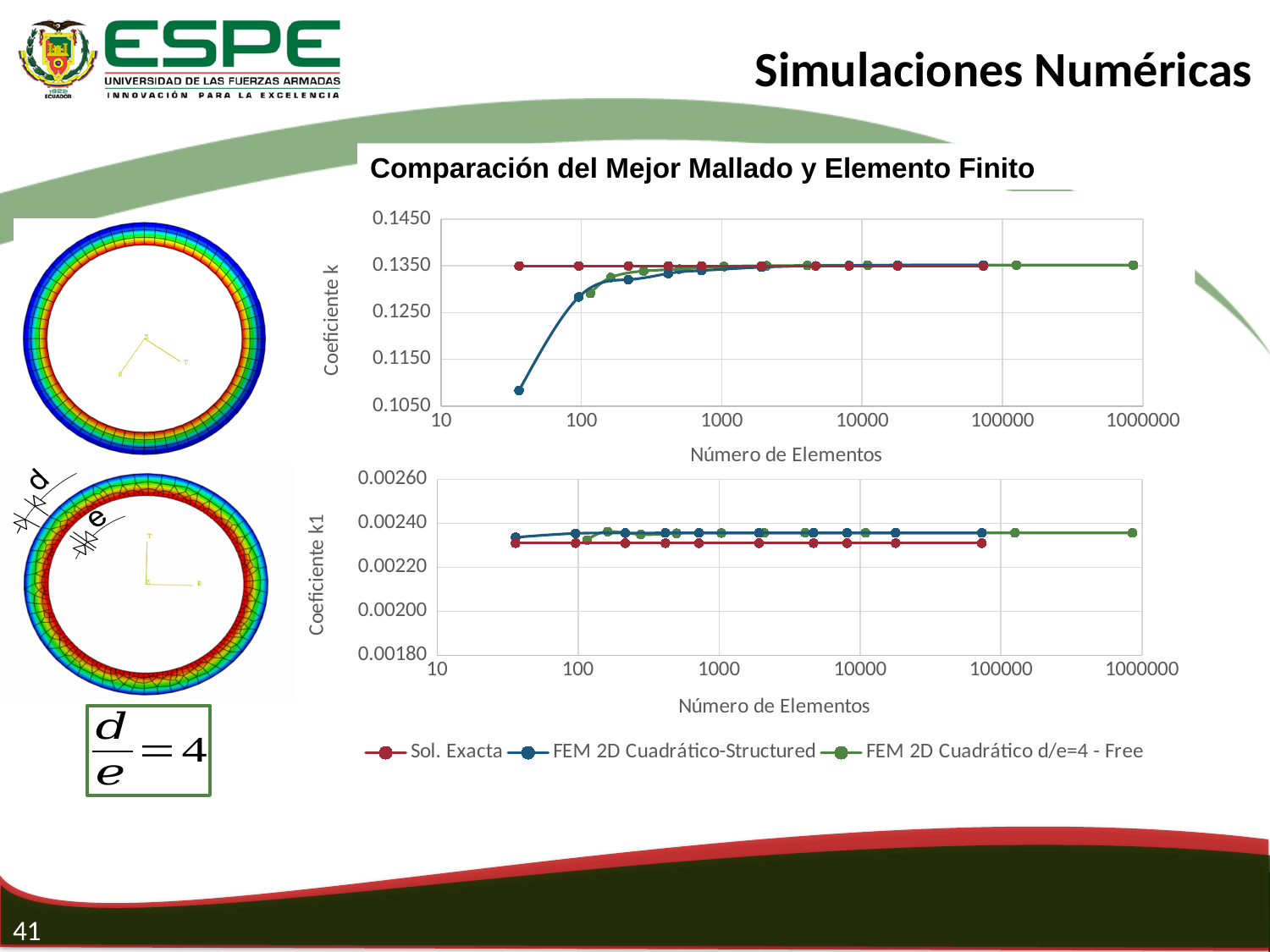
In the bottom chart (Coeficiente k1), which series lies higher: Sol. Exacta or FEM 2D Cuadrático-Structured? FEM 2D Cuadrático-Structured What is the x-axis title of the bottom chart? Número de Elementos In the bottom chart (Coeficiente k1), is the FEM 2D Cuadrático-Structured value greater or less than 0.00220? greater In the top chart (Coeficiente k), is the Sol. Exacta value greater or less than 0.1250? greater In the top chart (Coeficiente k), is the value of the FEM 2D Cuadrático-Structured series at its smallest number of elements greater or less than 0.1150? less What kind of chart is the top chart (Coeficiente k)? Line chart In the top chart (Coeficiente k), does the FEM 2D Cuadrático-Structured series rise or fall as the number of elements increases? Rises Which series is drawn in red in the charts? Sol. Exacta In the top chart (Coeficiente k), at the smallest number of elements, which is larger: Sol. Exacta or FEM 2D Cuadrático-Structured? Sol. Exacta How many charts are shown under the title 'Comparación del Mejor Mallado y Elemento Finito'? 2 How many series does the legend list for the charts? 3